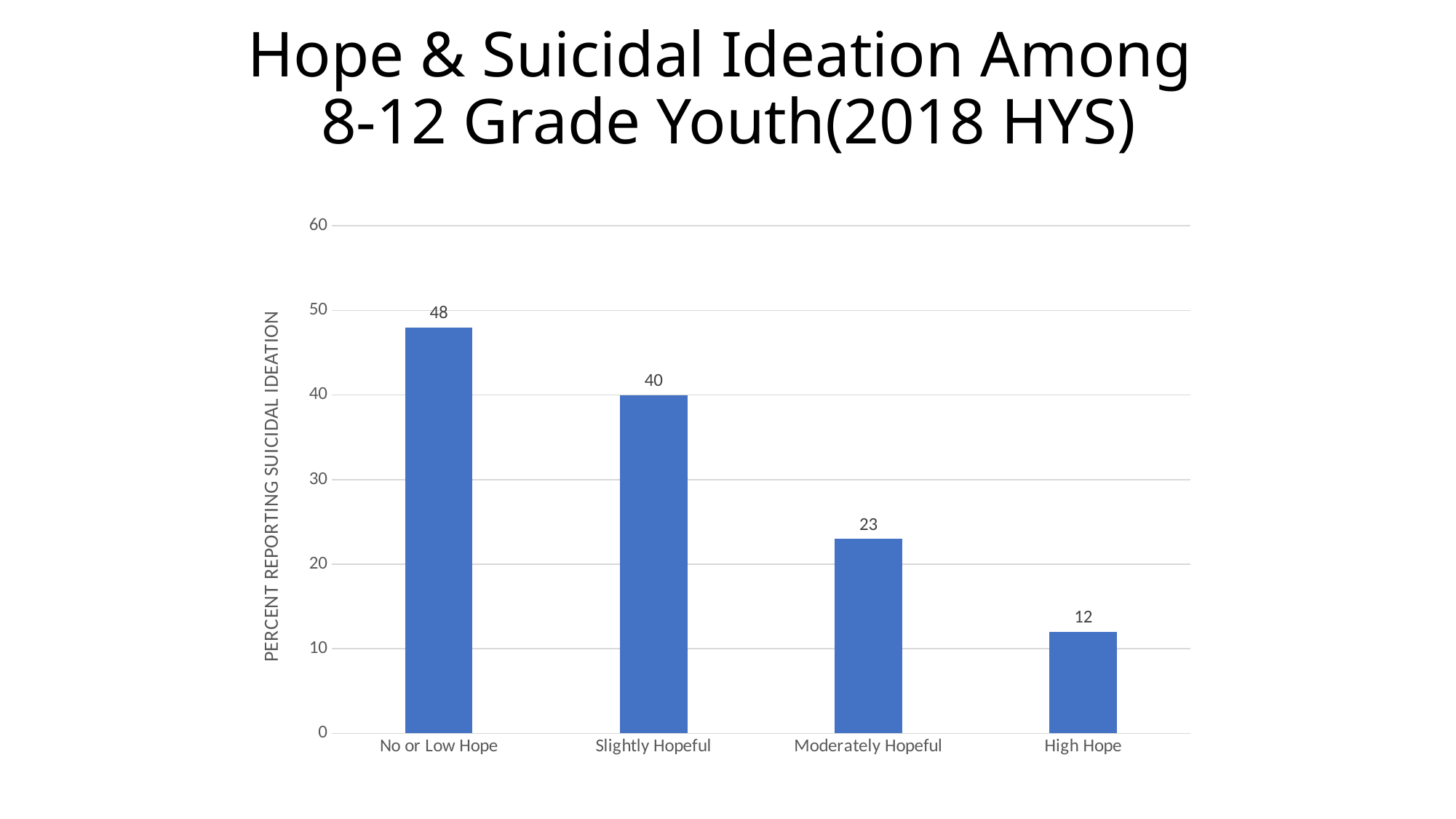
What is the value for High Hope? 12 How many categories are shown on the x axis? 4 What is the difference between the values for No or Low Hope and High Hope? 36 Which category has the highest value? No or Low Hope What kind of chart is shown on the slide? bar chart What is the value for Moderately Hopeful? 23 What is the value for No or Low Hope? 48 What is the value for Slightly Hopeful? 40 Is the value for Moderately Hopeful greater or less than 30? less Which category has the lowest value? High Hope Which is larger, the value for Slightly Hopeful or Moderately Hopeful? Slightly Hopeful Do the values rise or fall from left to right along the x axis? fall